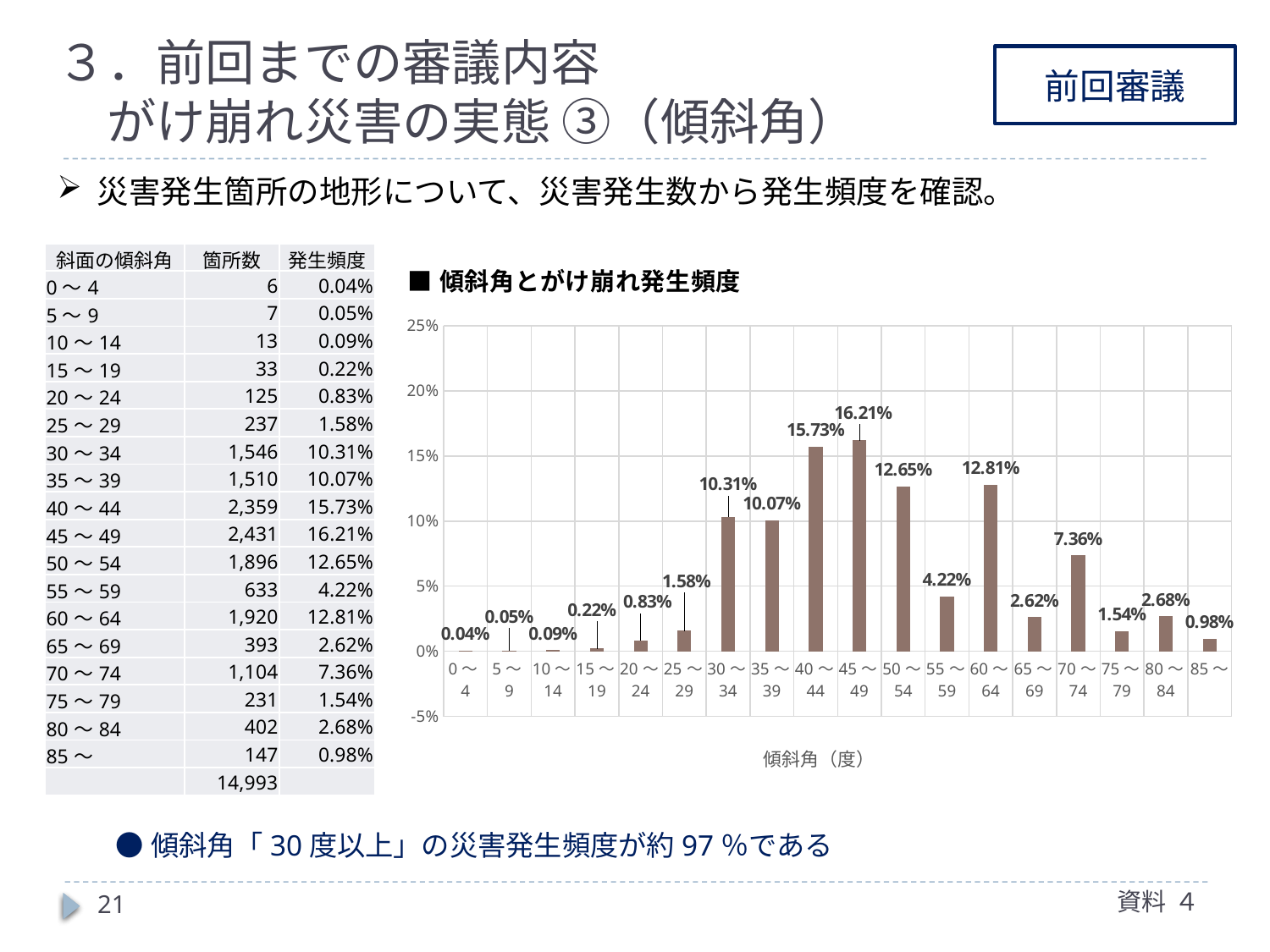
What is the value for the 45～49 category? 16.21% What is the difference between the values for 45～49 and 40～44? 0.48% Which is larger, the value for 30～34 or the value for 35～39? 30～34 Which slope-angle category has the highest value? 45～49 What is the x-axis title of the chart? 傾斜角（度） What is the value for the 85～ category? 0.98% Which slope-angle category has the lowest value? 0～4 How many slope-angle categories are plotted in the chart? 18 What is the value for the 60～64 category? 12.81% What type of chart is shown on the slide? bar chart What is the title of the chart? 傾斜角とがけ崩れ発生頻度 Is the value for 70～74 greater or less than 5%? greater